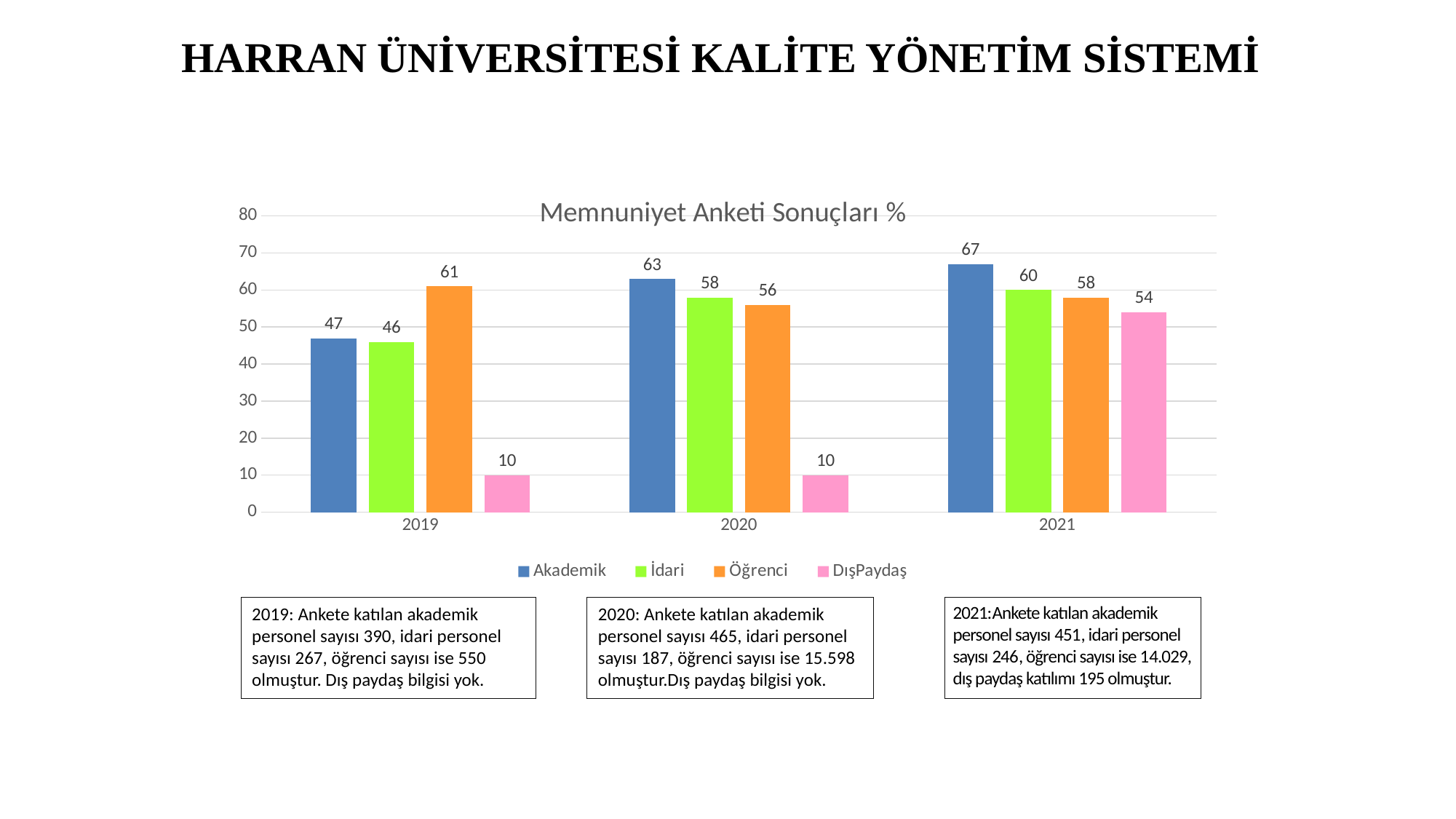
What is the value for Öğrenci in 2020? 56 What is the value for DışPaydaş in 2021? 54 Do the Akademik values rise or fall from 2019 to 2021? Rise Which is larger, the İdari value in 2020 or the Öğrenci value in 2020? İdari How many years are shown on the x axis? 3 How many series does the legend list? 4 Which series has the highest value in 2021? Akademik What is the value for Akademik in 2019? 47 What is the difference between the Akademik values for 2021 and 2019? 20 Which series has the lowest value in 2019? DışPaydaş What kind of chart is shown on the slide? Bar chart What is the title of the chart? Memnuniyet Anketi Sonuçları %